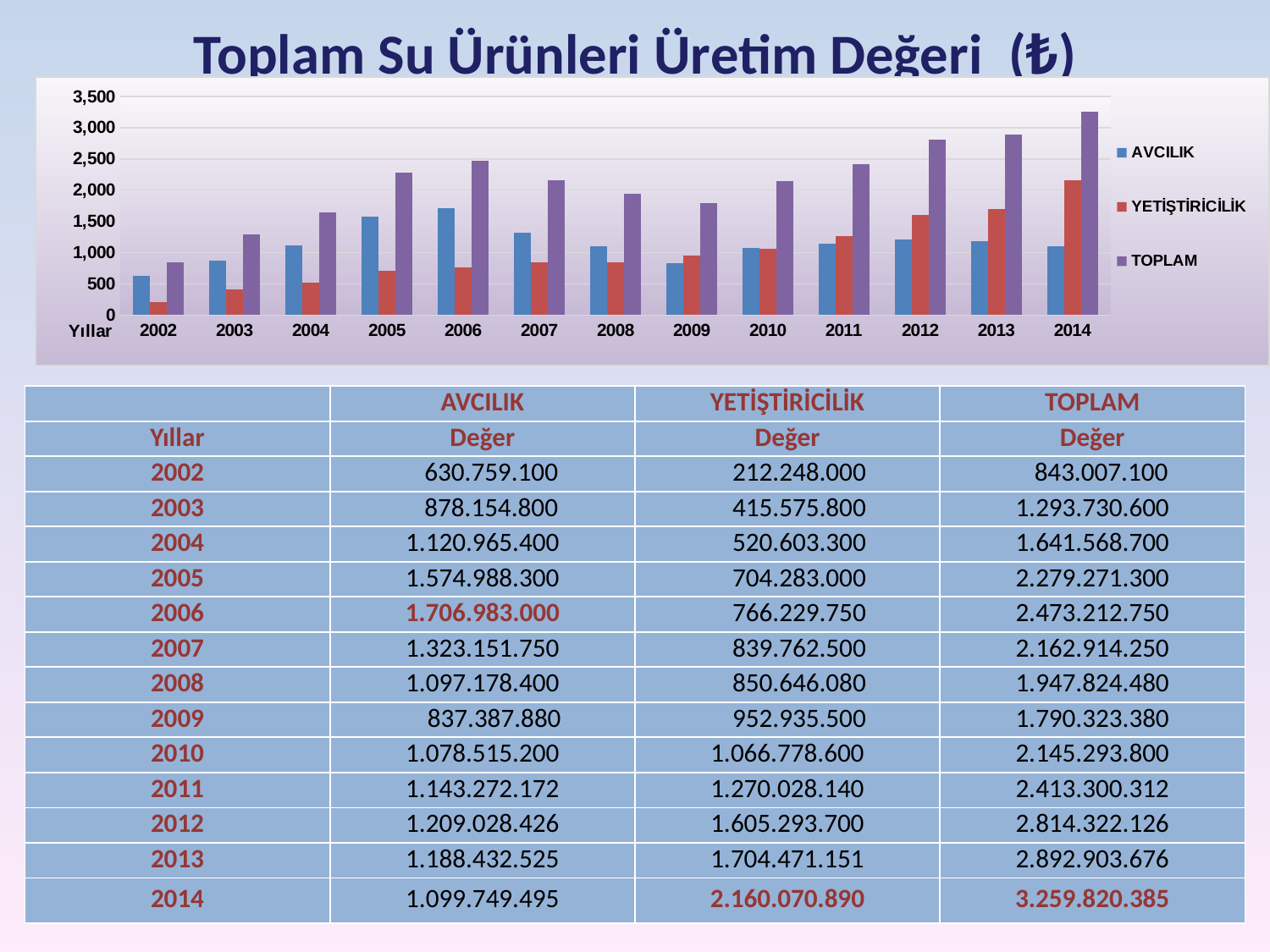
How many years are shown along the x axis of the chart? 13 In which year is the TOPLAM bar the highest? 2014 Is the TOPLAM value for 2014 greater or less than 3,000? greater In which year is the AVCILIK bar the highest? 2006 How many series does the chart legend list? 3 According to the table on the slide, what is the TOPLAM value for 2014? 3.259.820.385 Is the YETİŞTİRİCİLİK value for 2002 greater or less than 500? less In 2014, which is larger: the AVCILIK bar or the YETİŞTİRİCİLİK bar? YETİŞTİRİCİLİK Is the AVCILIK value for 2006 greater or less than 1,500? greater In which year is the YETİŞTİRİCİLİK bar the lowest? 2002 Does the TOPLAM series generally rise or fall from 2009 to 2014? rise What kind of chart is shown on the slide? bar chart